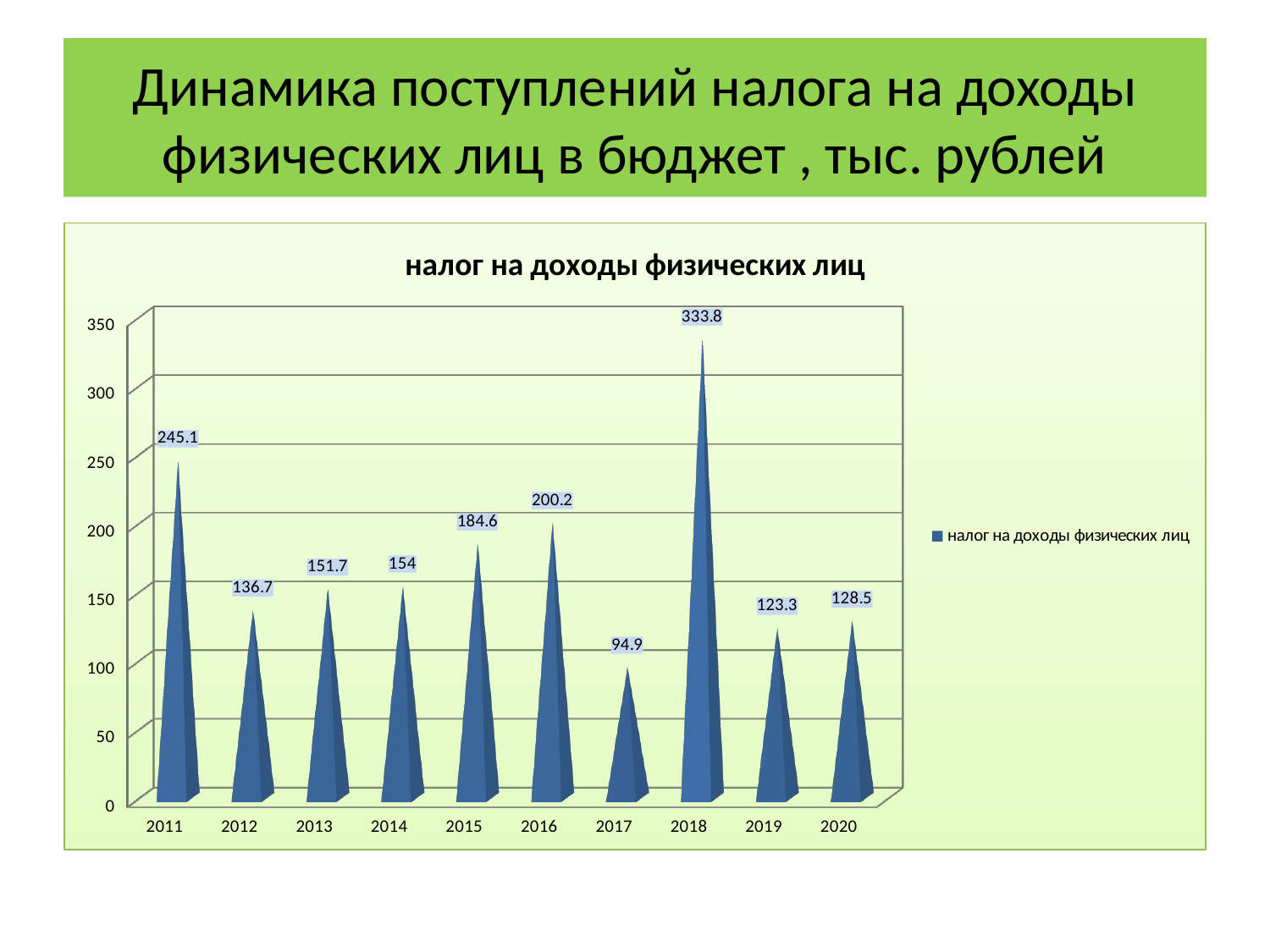
Which year has the lowest value? 2017 What is the value for 2018? 333.8 How many series does the legend list? 1 Which year has the highest value? 2018 How many years are shown on the x axis? 10 What is the value for 2011? 245.1 What is the value for 2017? 94.9 Is the value for 2014 greater or less than 150? greater What is the title of the chart? налог на доходы физических лиц Which is larger, the value for 2019 or the value for 2020? 2020 What is the difference between the values for 2016 and 2015? 15.6 What is the difference between the values for 2018 and 2017? 238.9